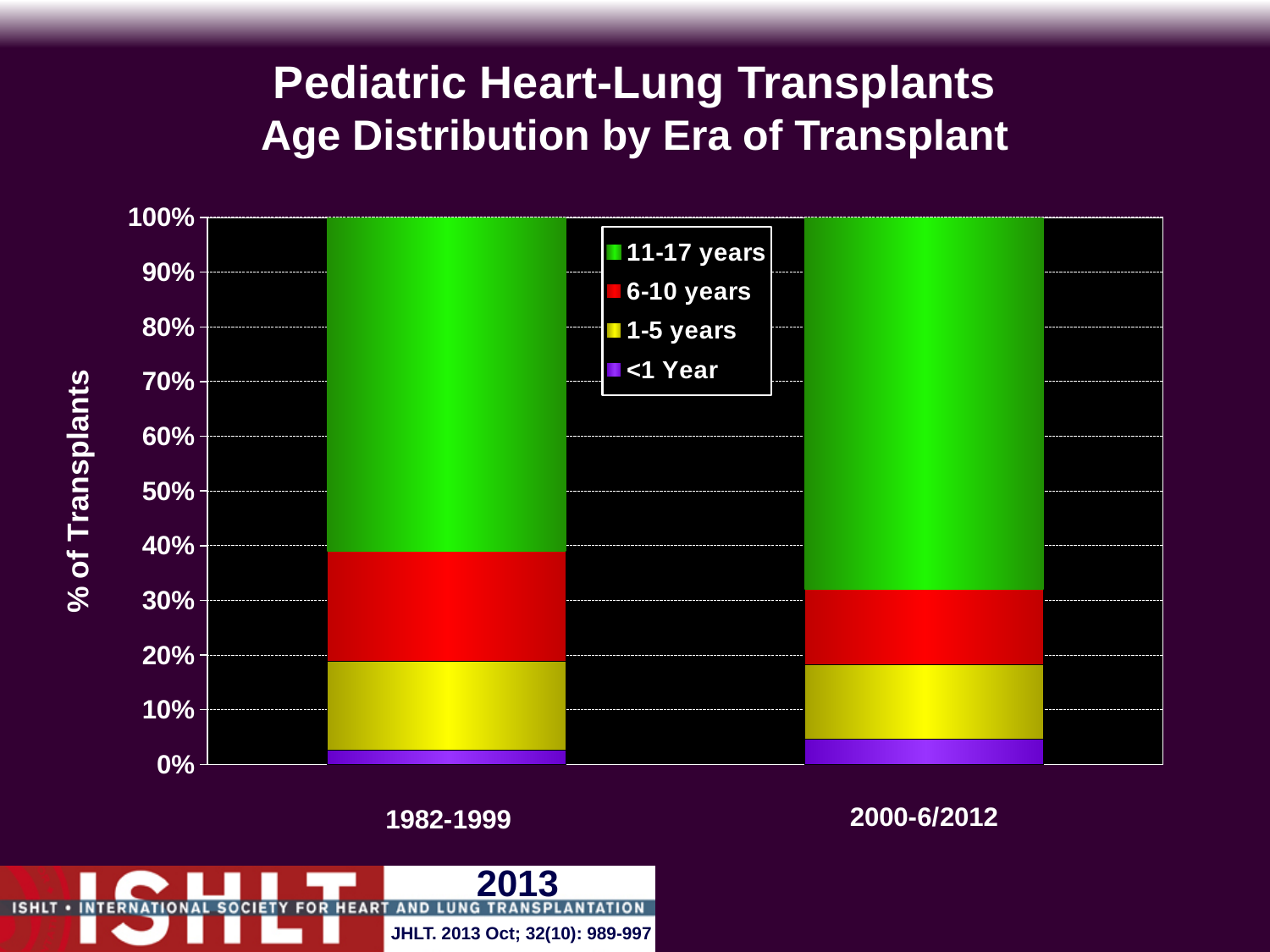
How many age groups does the legend list? 4 Is the share of <1 Year recipients in the 2000-6/2012 era greater or less than 10%? less What is the label on the y axis? % of Transplants Is the share of 11-17 years recipients in the 2000-6/2012 era greater or less than 60%? greater Which age group is shown in green in the legend? 11-17 years Which age group makes up the smallest share of transplants in the 2000-6/2012 era? <1 Year Which era has the larger share of 6-10 years recipients, 1982-1999 or 2000-6/2012? 1982-1999 Which age group makes up the largest share of transplants in the 1982-1999 era? 11-17 years Is the share of 11-17 years recipients in the 1982-1999 era greater or less than 50%? greater What kind of chart is shown on the slide? Stacked bar chart How many eras (categories) are shown on the x axis? 2 Which era has the larger share of 11-17 years recipients, 1982-1999 or 2000-6/2012? 2000-6/2012